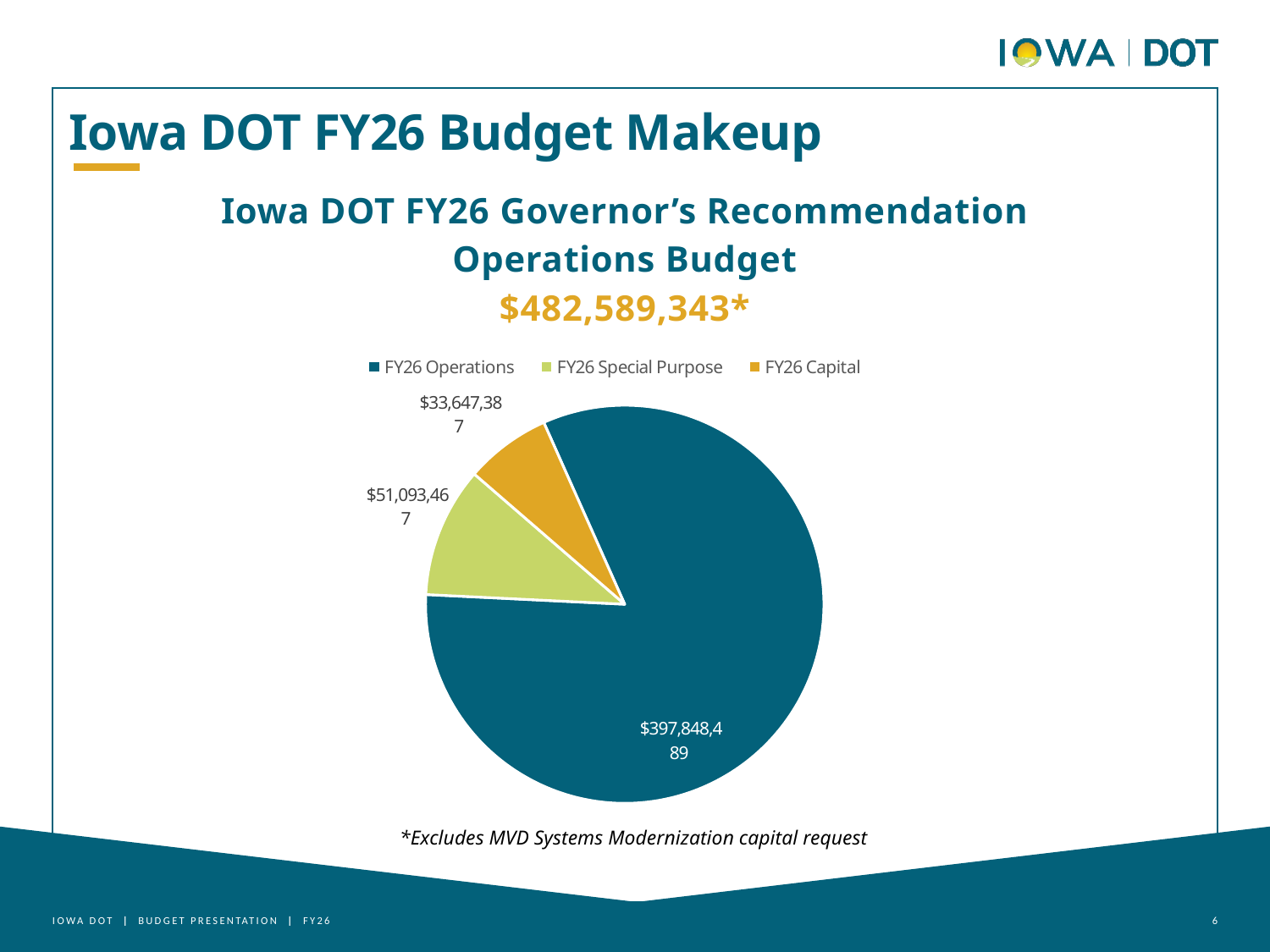
What is the value of the FY26 Operations slice? $397,848,489 What is the value of the FY26 Capital slice? $33,647,387 Which category has the largest slice of the pie? FY26 Operations How many slices does the pie chart have? 3 What is the difference between the FY26 Special Purpose and FY26 Capital values? $17,446,080 Which category has the smallest slice of the pie? FY26 Capital What is the difference between the FY26 Operations and FY26 Special Purpose values? $346,755,022 Which is larger, FY26 Special Purpose or FY26 Capital? FY26 Special Purpose What total operations budget amount is shown above the pie chart? $482,589,343* What type of chart is shown on the slide? Pie chart How many entries does the legend list? 3 What is the value of the FY26 Special Purpose slice? $51,093,467